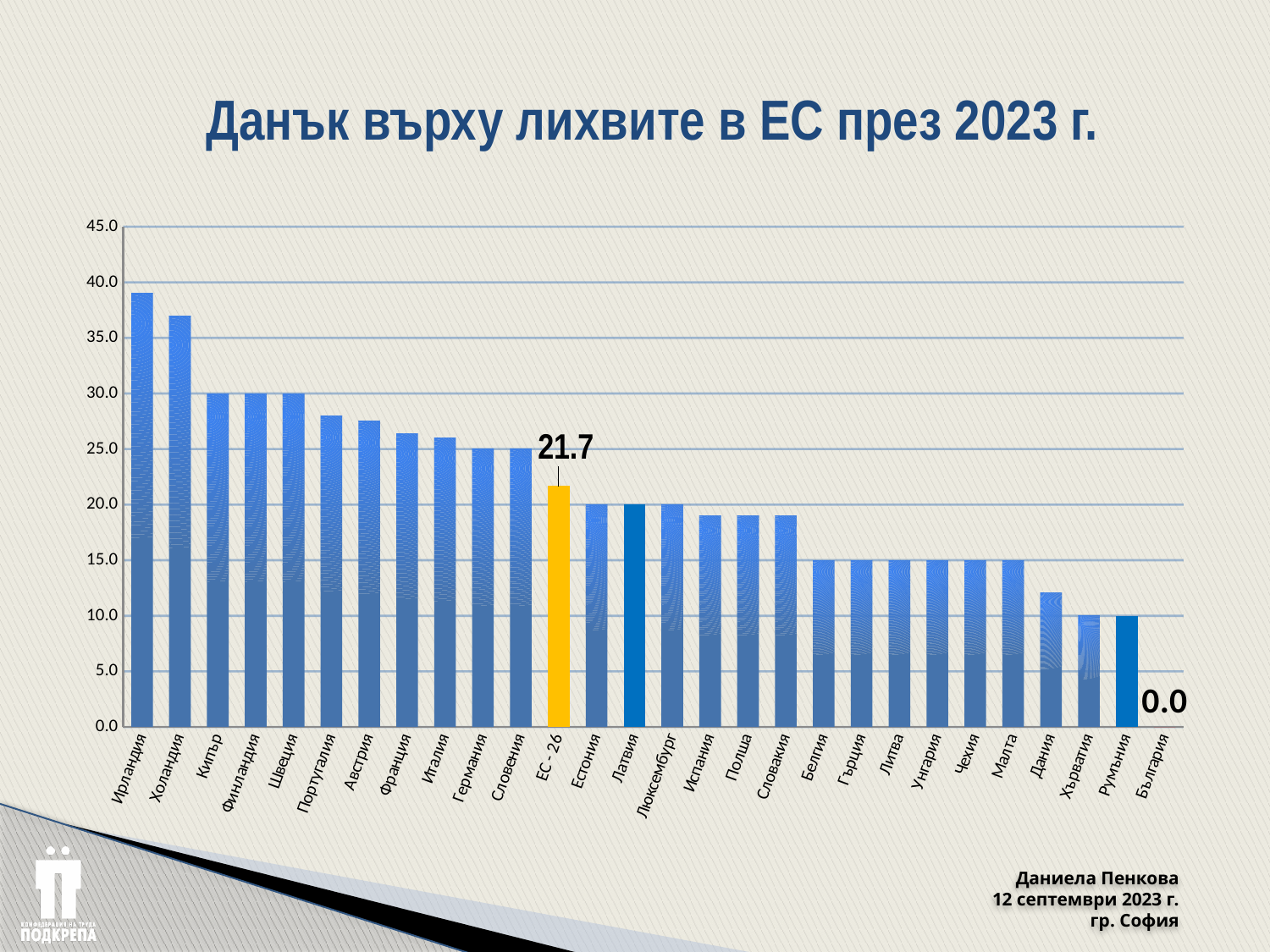
Which has a larger value, Дания or Хърватия? Дания What is the title of the chart? Данък върху лихвите в ЕС през 2023 г. Which country has the highest value in the chart? Ирландия Is the value for Дания greater or less than 10.0? greater How many categories (bars) are shown on the x axis? 28 Is the value for Ирландия greater or less than 35.0? greater What is the difference between the value for ЕС - 26 and the value for България? 21.7 What is the value for ЕС - 26? 21.7 What is the value for България? 0.0 Which country has the lowest value in the chart? България What type of chart is shown on the slide? bar chart